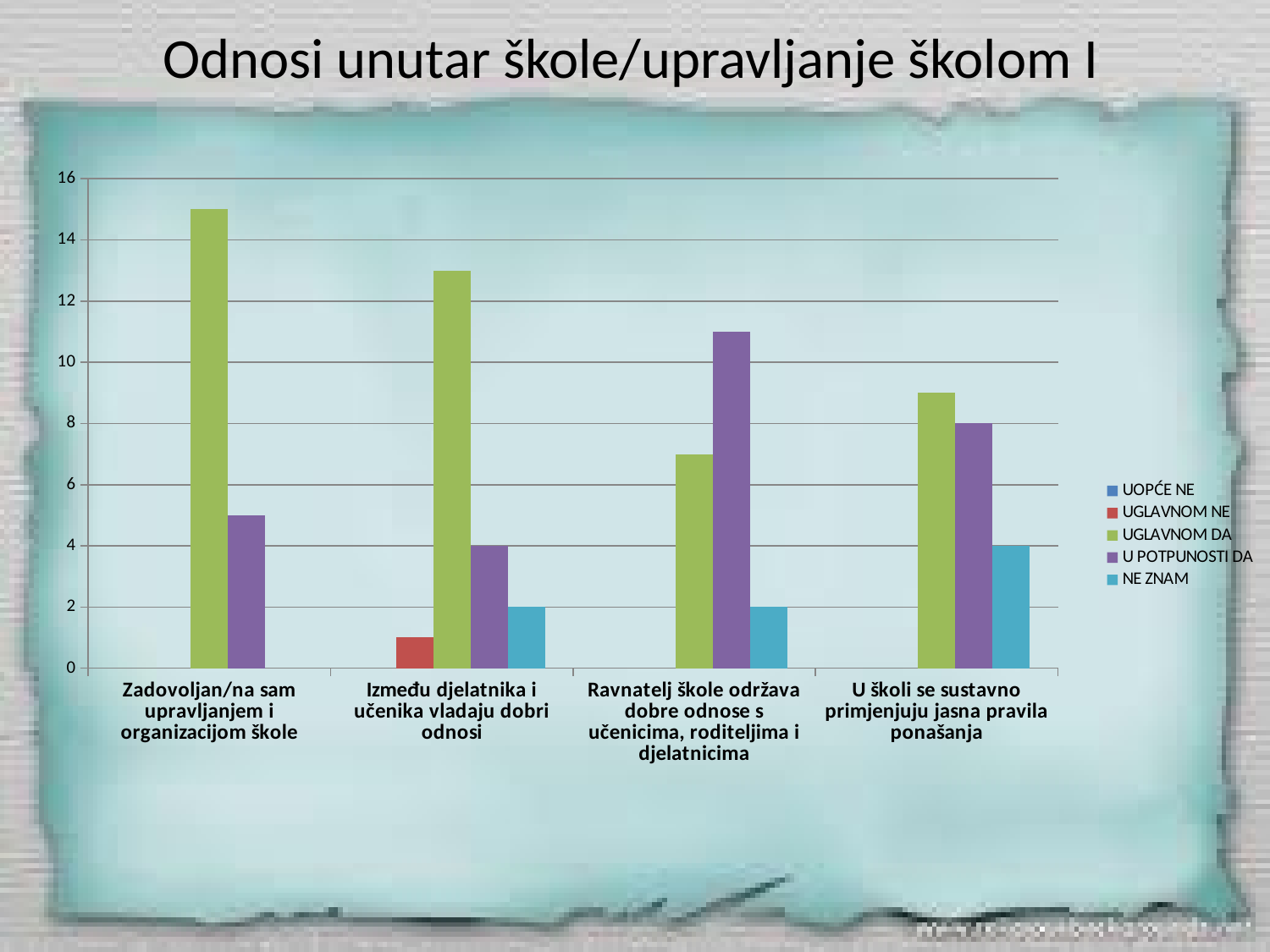
What is the value of U POTPUNOSTI DA for "U školi se sustavno primjenjuju jasna pravila ponašanja"? 8 What is the value of NE ZNAM for "U školi se sustavno primjenjuju jasna pravila ponašanja"? 4 What is the value of U POTPUNOSTI DA for "Između djelatnika i učenika vladaju dobri odnosi"? 4 What is the value of NE ZNAM for "Ravnatelj škole održava dobre odnose s učenicima, roditeljima i djelatnicima"? 2 Is the UGLAVNOM DA value for "Zadovoljan/na sam upravljanjem i organizacijom škole" greater or less than 14? greater For "Ravnatelj škole održava dobre odnose s učenicima, roditeljima i djelatnicima", which is larger: UGLAVNOM DA or U POTPUNOSTI DA? U POTPUNOSTI DA How many categories are shown on the x axis? 4 Which category has the highest UGLAVNOM DA value? Zadovoljan/na sam upravljanjem i organizacijom škole Which category is the only one with a UGLAVNOM NE bar? Između djelatnika i učenika vladaju dobri odnosi Is the U POTPUNOSTI DA value for "Ravnatelj škole održava dobre odnose s učenicima, roditeljima i djelatnicima" greater or less than 10? greater How many series does the legend list? 5 What kind of chart is shown on the slide? bar chart